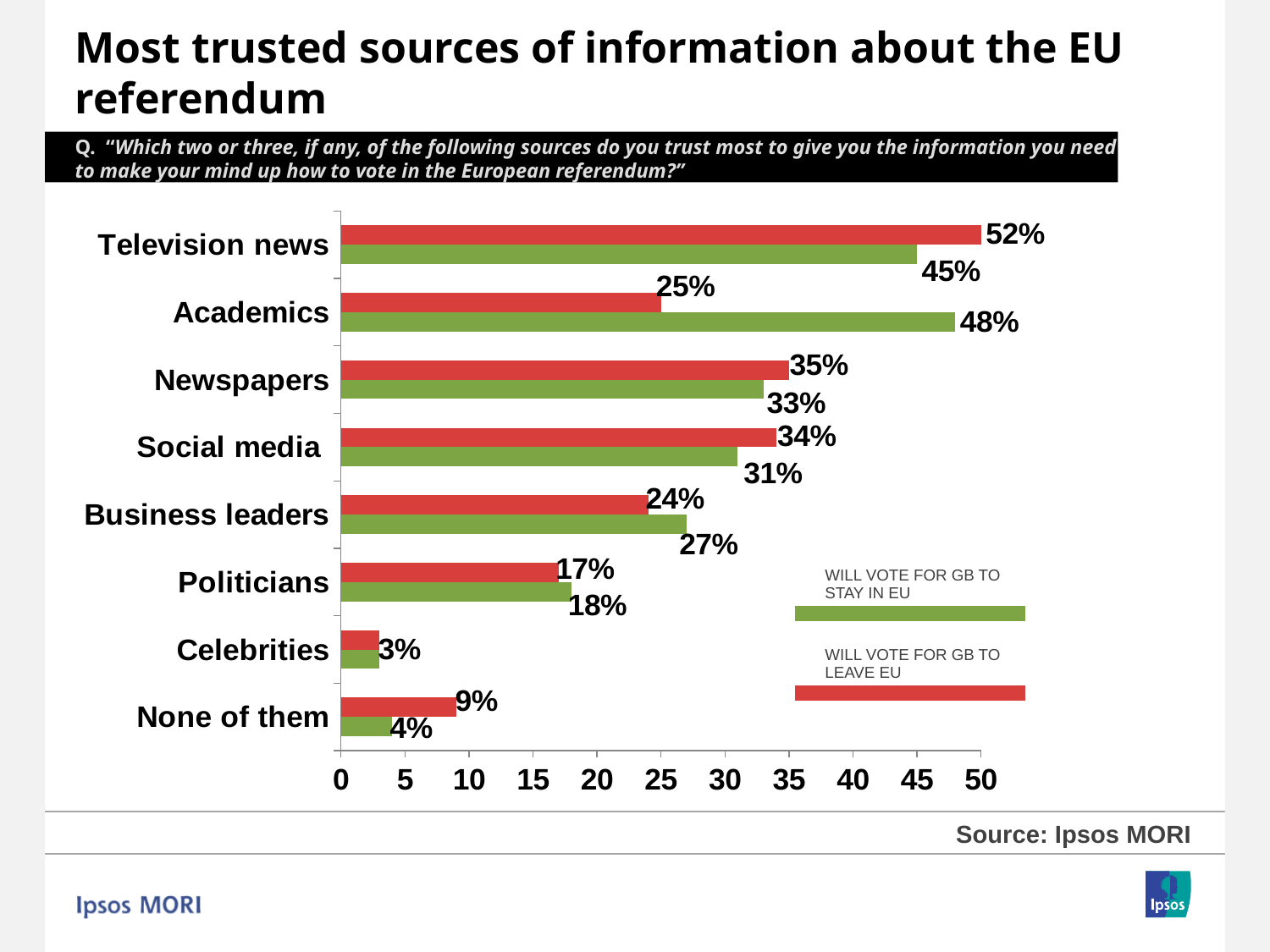
What percentage of those who will vote to leave the EU chose 'None of them'? 9% What kind of chart is shown on the slide? Bar chart What percentage of those who will vote for GB to leave the EU trust television news? 52% Is the value for celebrities among those who will vote to stay in the EU greater or less than 5? less For academics, what is the difference between the stay-in-EU and leave-EU percentages? 23 percentage points Which source is most trusted by those who will vote for GB to stay in the EU? Academics How many sources (categories) are shown on the chart? 8 Which source is most trusted by those who will vote for GB to leave the EU? Television news For television news, what is the difference between the leave-EU and stay-in-EU percentages? 7 percentage points For business leaders, which group shows the higher percentage: those who will vote to stay or those who will vote to leave? Those who will vote to stay How many series does the chart's legend list? 2 What percentage of those who will vote for GB to stay in the EU trust academics? 48%